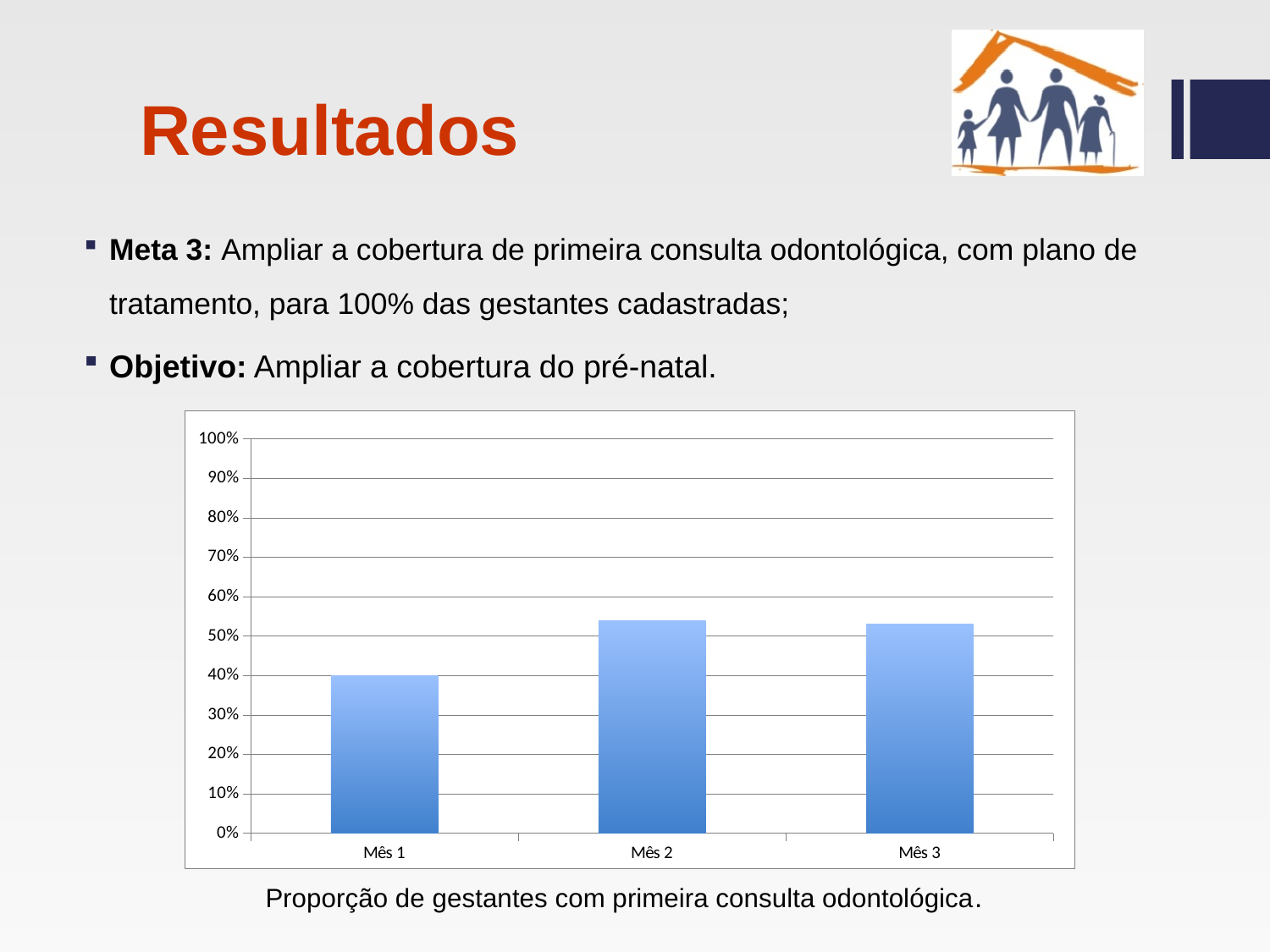
Does the value rise or fall from Mês 1 to Mês 2? rise What is the value for Mês 1? 40% Is the value for Mês 2 greater or less than 50%? greater Which month has the lowest value in the chart? Mês 1 How many categories (months) are plotted in the chart? 3 Which is larger, the value for Mês 1 or the value for Mês 2? Mês 2 What kind of chart is shown on the slide? bar chart Is the value for Mês 2 greater or less than 60%? less Is the value for Mês 3 greater or less than 50%? greater What is the highest value shown on the chart's vertical axis? 100% What is the caption given below the chart? Proporção de gestantes com primeira consulta odontológica.